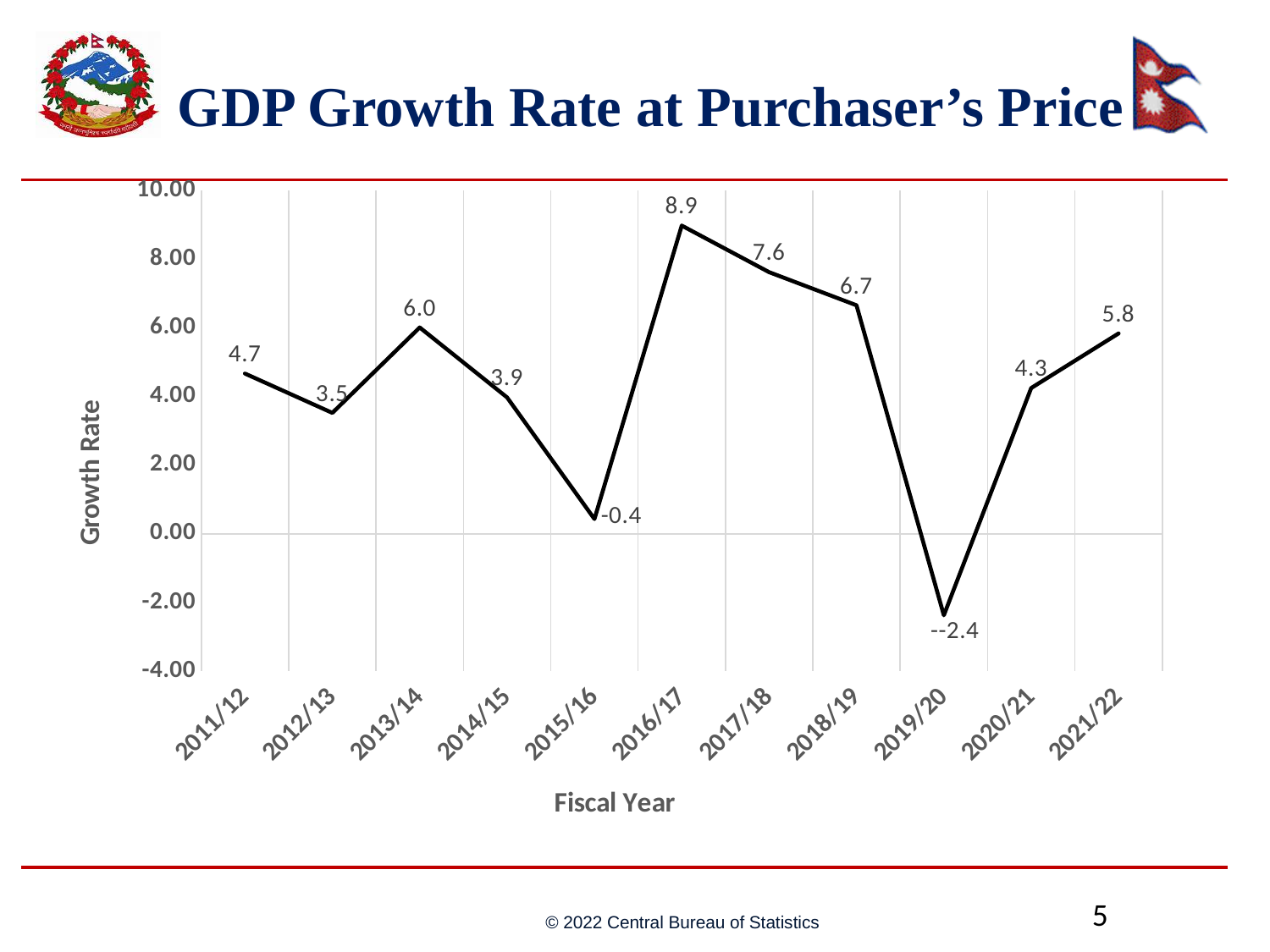
What is the difference between the growth rate in 2016/17 and in 2011/12? 4.2 What is the GDP growth rate for fiscal year 2021/22? 5.8 What is the GDP growth rate for fiscal year 2016/17? 8.9 Which fiscal year has the highest GDP growth rate? 2016/17 How many fiscal years are plotted on the chart? 11 What is the GDP growth rate for fiscal year 2015/16? -0.4 Does the growth rate rise or fall from 2016/17 to 2019/20? fall Which fiscal year has the lowest GDP growth rate? 2019/20 What kind of chart is shown on the slide? line chart What is the GDP growth rate for fiscal year 2013/14? 6.0 Which fiscal year has a higher growth rate, 2017/18 or 2018/19? 2017/18 What is the label of the vertical axis? Growth Rate